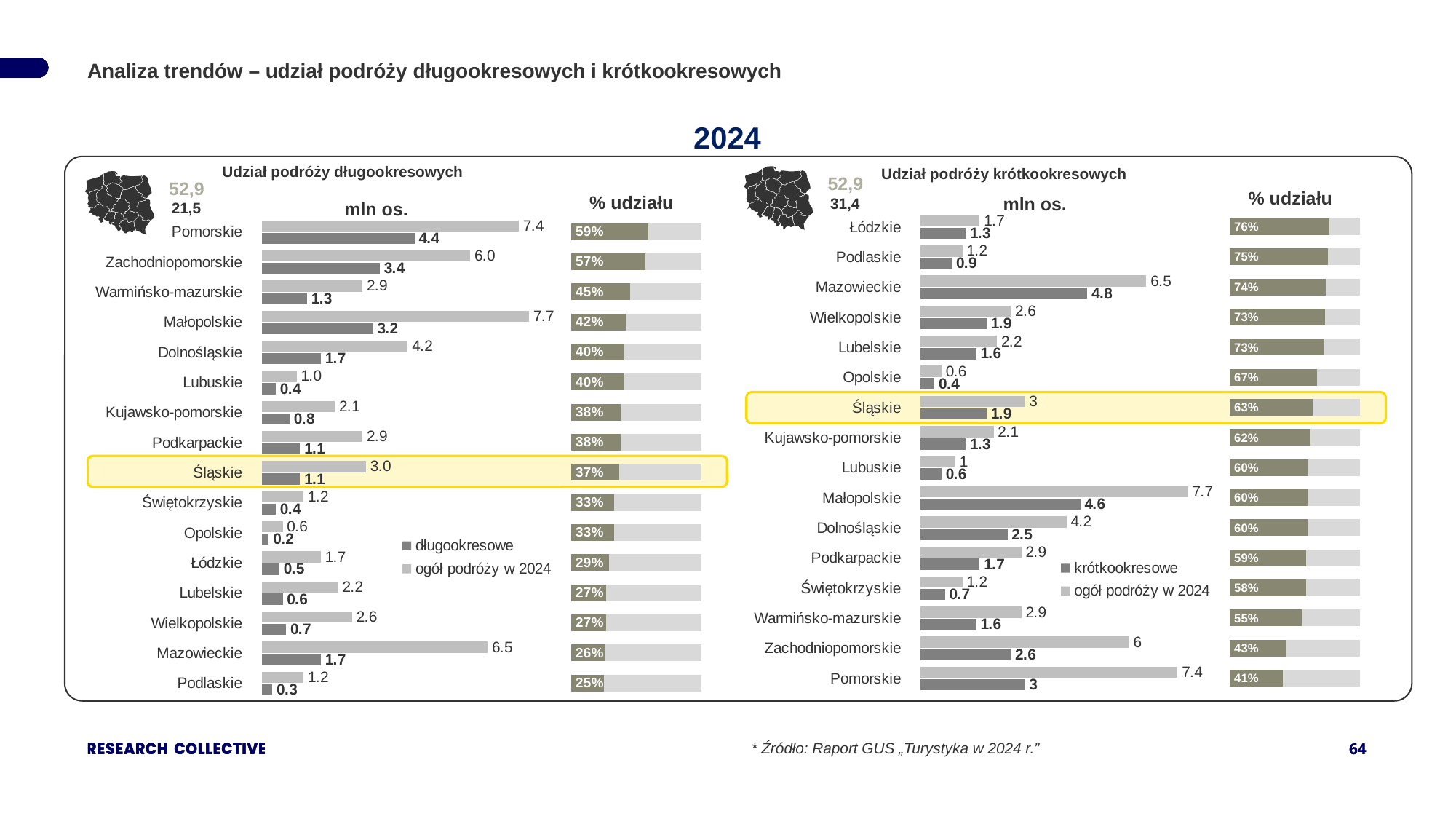
In the right chart (Udział podróży krótkookresowych), what is the value of krótkookresowe for Mazowieckie? 4.8 In the left chart (Udział podróży długookresowych), which region has the lowest % udziału? Podlaskie In the right chart (Udział podróży krótkookresowych), which region has the lowest % udziału? Pomorskie In the right chart (Udział podróży krótkookresowych), which is larger: krótkookresowe for Małopolskie or for Dolnośląskie? Małopolskie What type of chart is used in the left chart (Udział podróży długookresowych) to show mln os.? Bar chart In the left chart (Udział podróży długookresowych), which region has the highest ogół podróży w 2024 value? Małopolskie In the right chart (Udział podróży krótkookresowych), which region has the highest % udziału? Łódzkie In the left chart (Udział podróży długookresowych), what is the value of długookresowe for Pomorskie? 4.4 In the left chart (Udział podróży długookresowych), what is the % udziału for Śląskie? 37% How many regions are listed in the left chart (Udział podróży długookresowych)? 16 How many series does the legend of the right chart (Udział podróży krótkookresowych) list? 2 In the left chart (Udział podróży długookresowych), what is the difference between ogół podróży w 2024 and długookresowe for Mazowieckie? 4.8